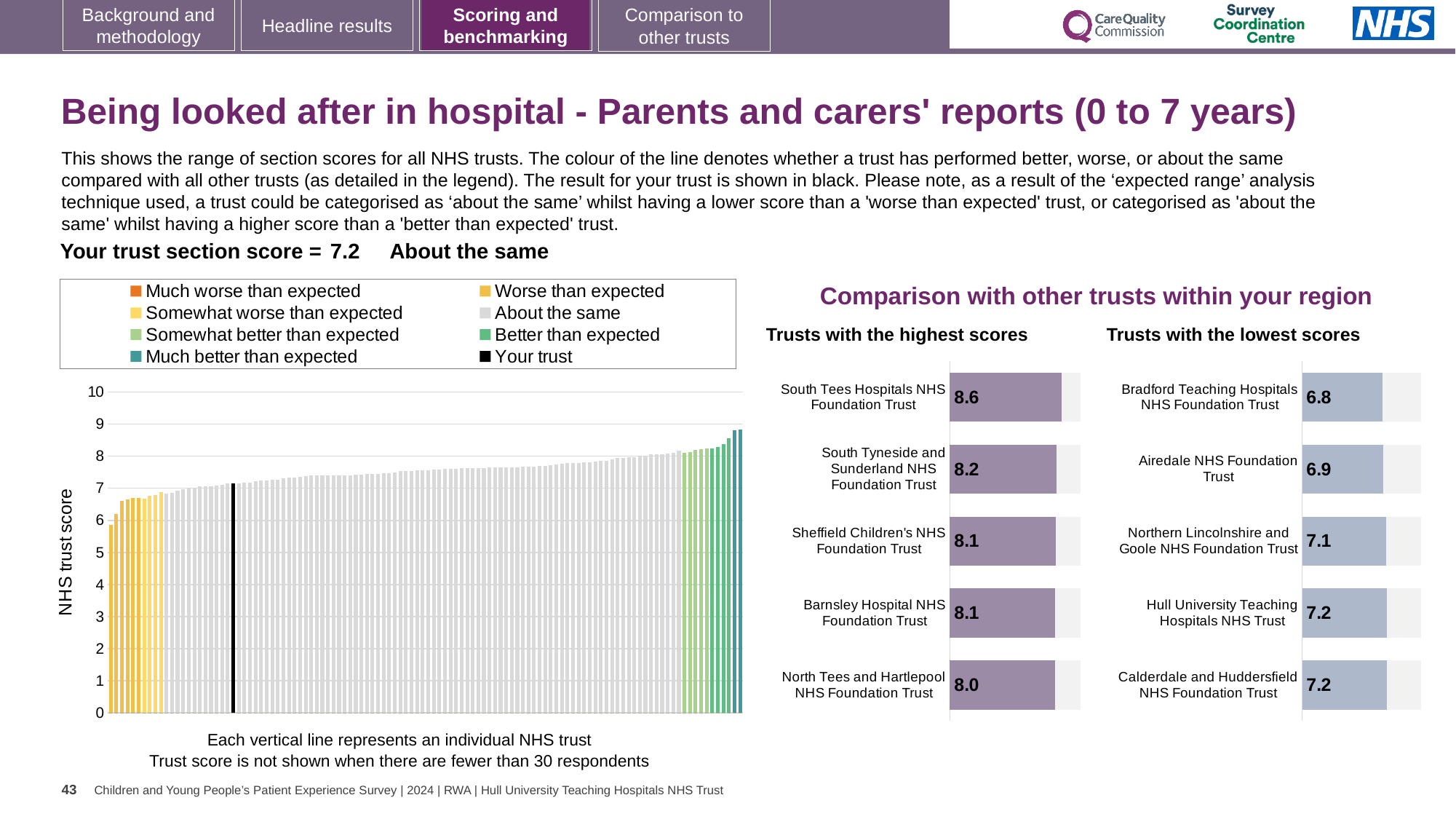
In the 'Trusts with the lowest scores' chart, which trust has the lowest score? Bradford Teaching Hospitals NHS Foundation Trust In the 'Trusts with the highest scores' chart, what is the score for South Tees Hospitals NHS Foundation Trust? 8.6 In the 'Trusts with the lowest scores' chart, what is the difference between the scores of Airedale NHS Foundation Trust and Bradford Teaching Hospitals NHS Foundation Trust? 0.1 In the 'Trusts with the highest scores' chart, what is the difference between the scores of South Tees Hospitals NHS Foundation Trust and North Tees and Hartlepool NHS Foundation Trust? 0.6 In the 'Trusts with the lowest scores' chart, what is the score for Bradford Teaching Hospitals NHS Foundation Trust? 6.8 In the 'Trusts with the highest scores' chart, which trust has the highest score? South Tees Hospitals NHS Foundation Trust In the 'Trusts with the highest scores' chart, which has the larger score: South Tyneside and Sunderland NHS Foundation Trust or Sheffield Children's NHS Foundation Trust? South Tyneside and Sunderland NHS Foundation Trust In the large 'NHS trust score' chart on the left, do the bar values rise or fall from left to right? Rise How many trusts are shown in the 'Trusts with the highest scores' chart? 5 What kind of chart is the large 'NHS trust score' chart on the left of the slide? Bar chart In the 'Trusts with the lowest scores' chart, what is the score for Hull University Teaching Hospitals NHS Trust? 7.2 How many entries does the legend above the large 'NHS trust score' chart list? 8